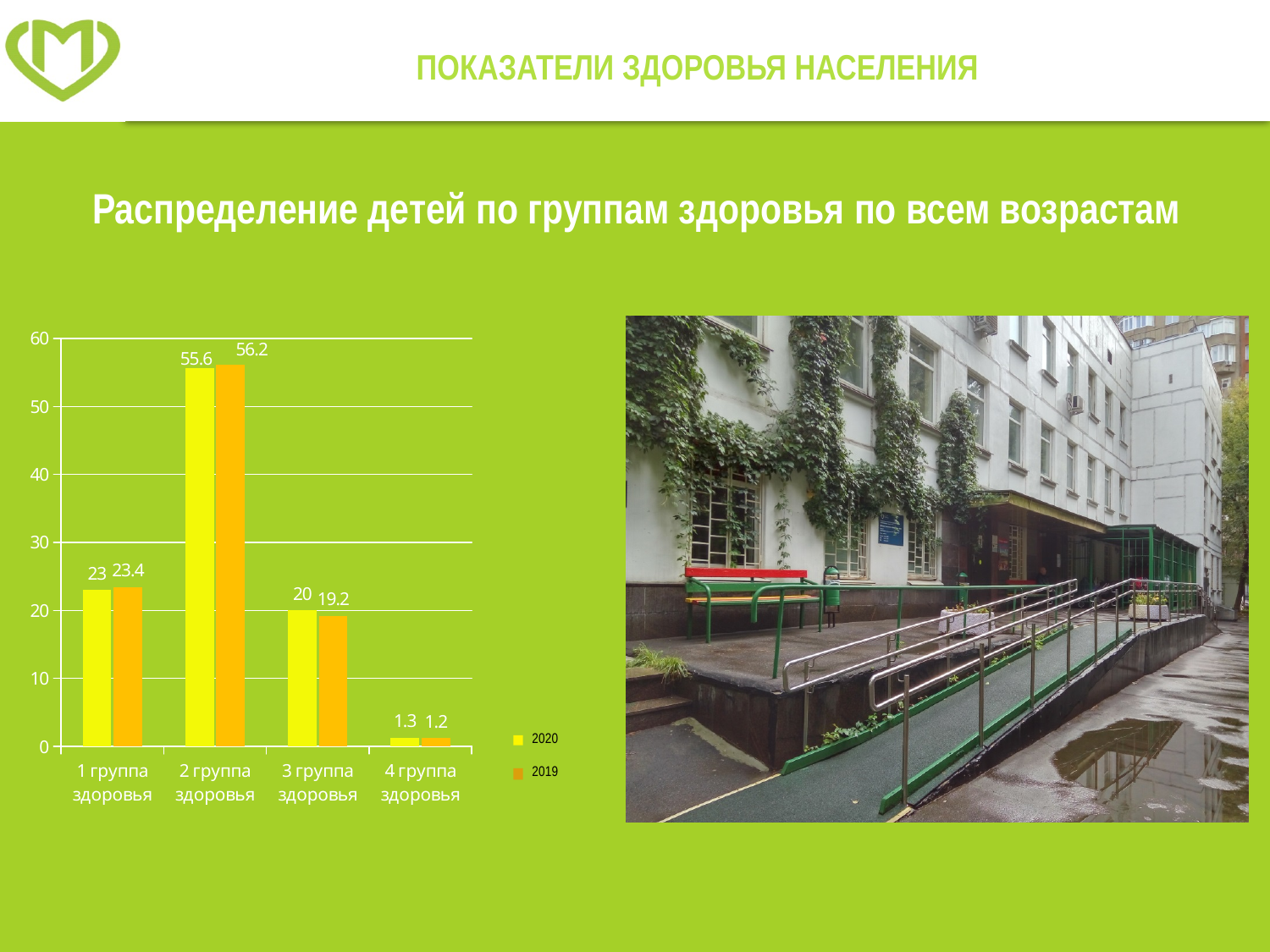
Which colour represents the 2019 series in the chart? Orange What is the value for 4 группа здоровья in the 2020 series? 1.3 What is the value for 2 группа здоровья in the 2020 series? 55.6 Which health group has the highest value in the 2019 series? 2 группа здоровья What is the value for 1 группа здоровья in the 2019 series? 23.4 What is the value for 3 группа здоровья in the 2019 series? 19.2 For 3 группа здоровья, which series has the larger value, 2020 or 2019? 2020 What kind of chart is shown on the slide? Bar chart Which health group has the lowest value in the 2020 series? 4 группа здоровья How many series does the legend list? 2 How many health group categories are shown on the x axis? 4 What is the difference between the 2019 and 2020 values for 2 группа здоровья? 0.6